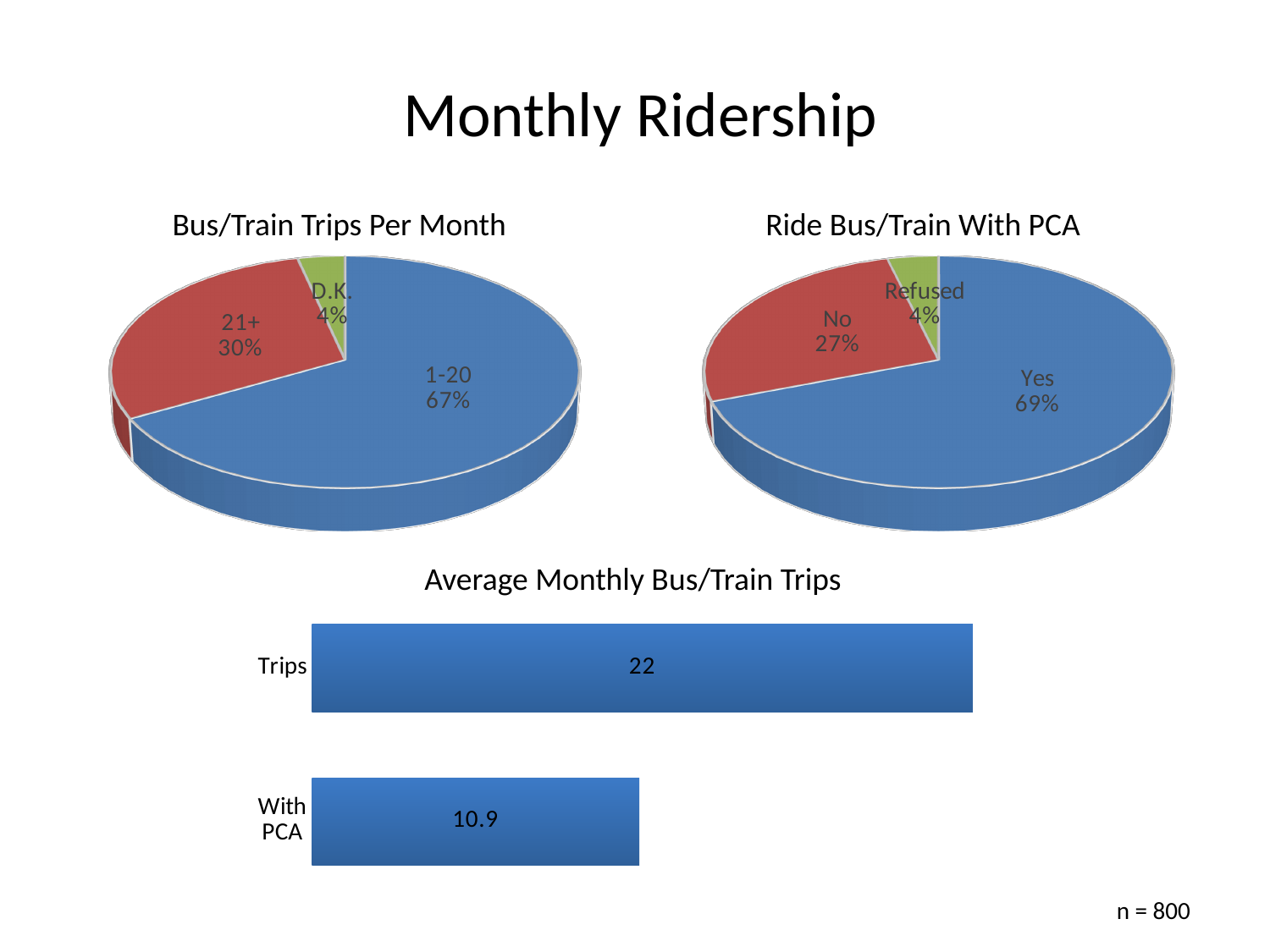
In the 'Bus/Train Trips Per Month' chart, which category has the smallest slice? D.K. In the 'Ride Bus/Train With PCA' chart, what share of the pie is the 'No' slice? 27% In the 'Average Monthly Bus/Train Trips' chart, what is the value for 'With PCA'? 10.9 In the 'Ride Bus/Train With PCA' chart, what share of the pie is the 'Yes' slice? 69% In the 'Bus/Train Trips Per Month' chart, what share of the pie is the '1-20' slice? 67% In the 'Average Monthly Bus/Train Trips' chart, what is the difference between 'Trips' and 'With PCA'? 11.1 In the 'Bus/Train Trips Per Month' chart, how many slices does the pie have? 3 In the 'Average Monthly Bus/Train Trips' chart, which is larger, 'Trips' or 'With PCA'? Trips In the 'Ride Bus/Train With PCA' chart, what is the difference in percentage points between the 'Yes' and 'No' slices? 42 What kind of chart is 'Average Monthly Bus/Train Trips'? Bar chart In the 'Ride Bus/Train With PCA' chart, which category has the largest slice? Yes